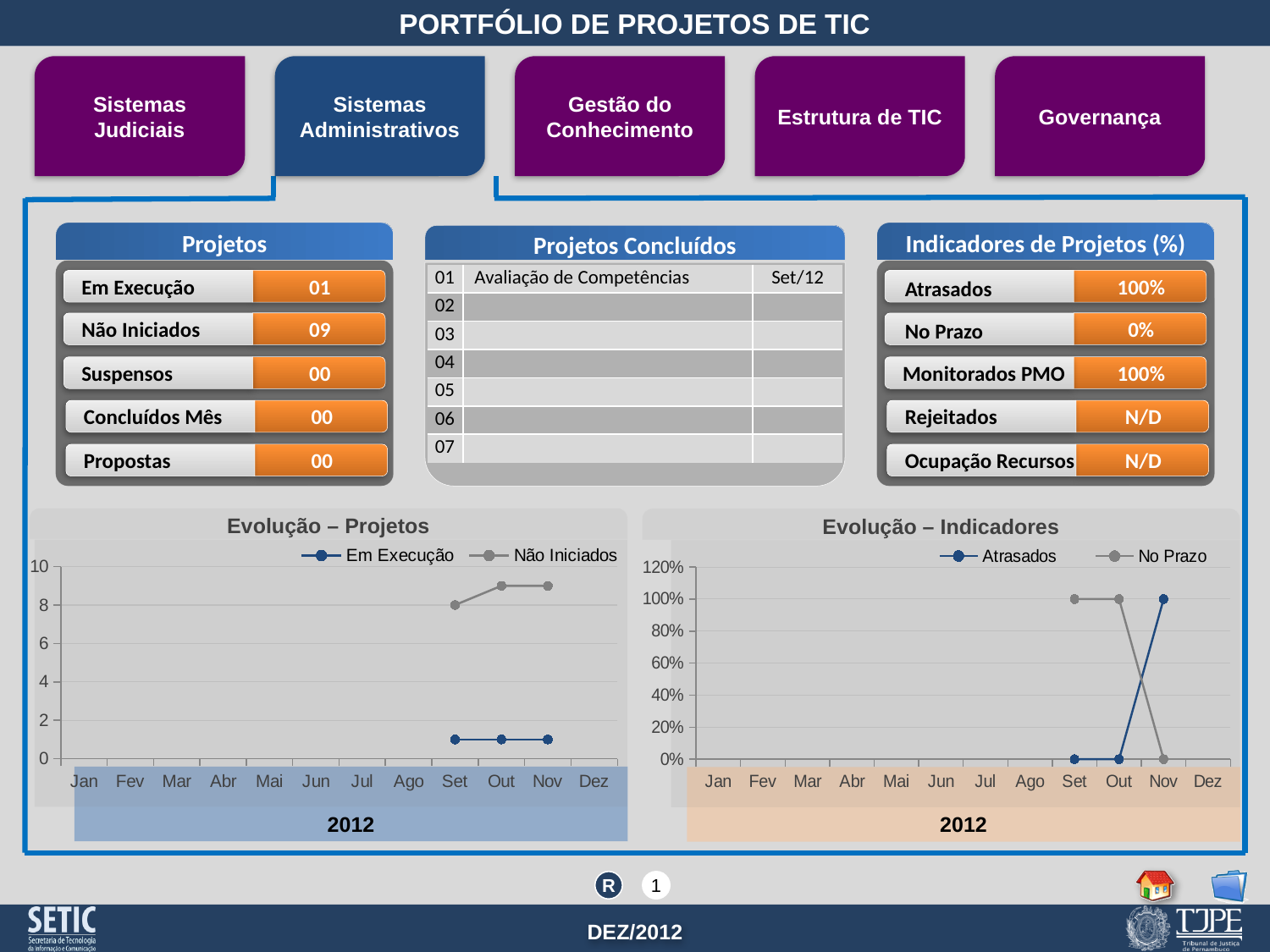
In the 'Evolução – Projetos' chart, which series has the higher value in Set, Em Execução or Não Iniciados? Não Iniciados In the 'Evolução – Indicadores' chart, how many months are labelled on the x axis? 12 In the 'Evolução – Projetos' chart, is the value for Em Execução in Out greater or less than 2? less In the 'Evolução – Indicadores' chart, what is the value of Atrasados in Nov? 100% In the 'Evolução – Indicadores' chart, which two series does the legend list? Atrasados and No Prazo In the 'Evolução – Projetos' chart, what is the value of Não Iniciados in Set? 8 In the 'Evolução – Projetos' chart, what kind of chart is shown? line chart In the 'Evolução – Indicadores' chart, does the Atrasados series rise or fall from Out to Nov? rise In the 'Evolução – Indicadores' chart, what is the value of No Prazo in Nov? 0% In the 'Evolução – Projetos' chart, how many series does the legend list? 2